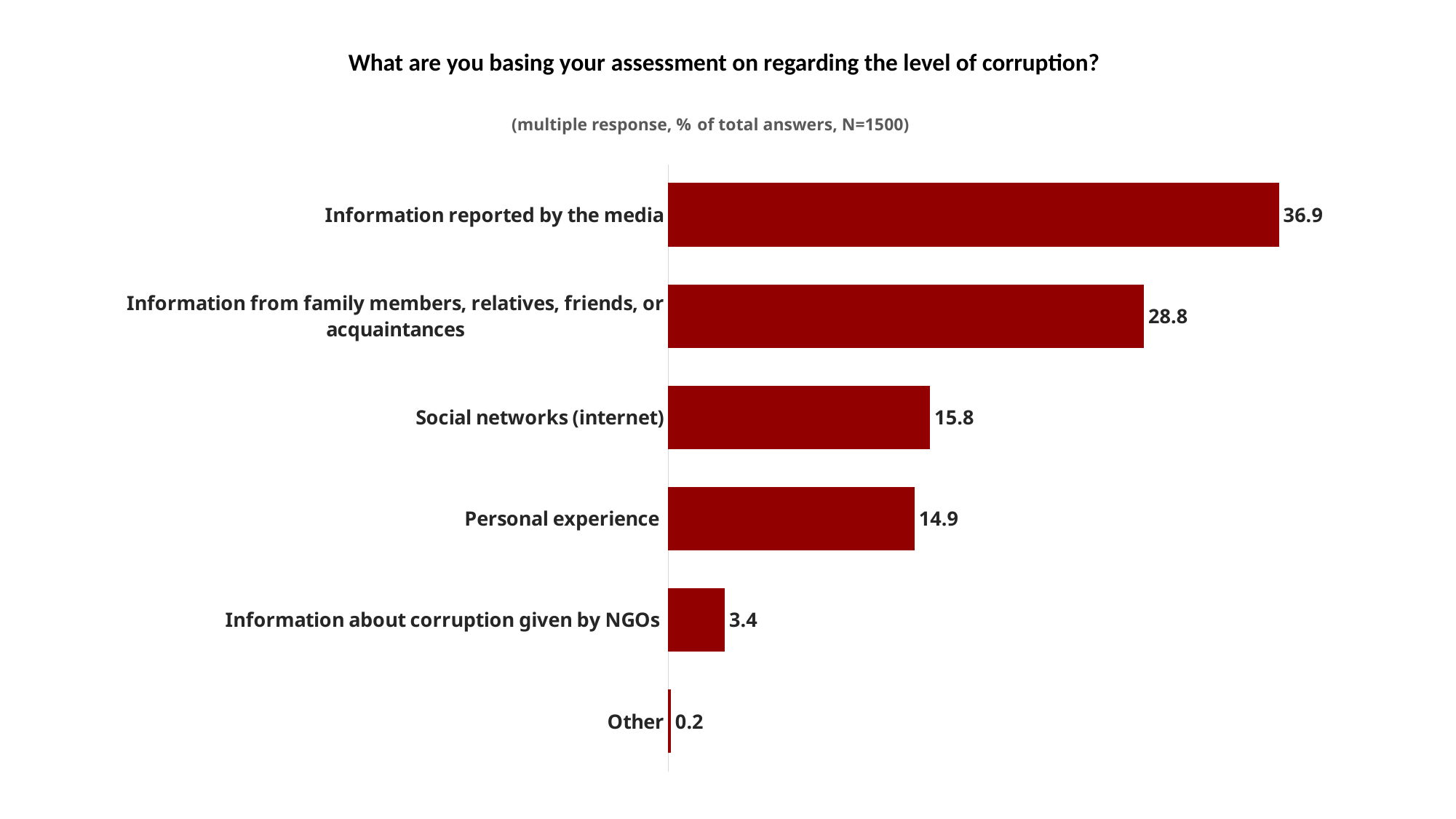
What is the sample size (N) stated in the chart subtitle? N=1500 What kind of chart is shown on the slide? Bar chart Which is larger, the value for "Personal experience" or the value for "Information about corruption given by NGOs"? Personal experience What is the value for "Information reported by the media"? 36.9 What is the value for "Social networks (internet)"? 15.8 What is the difference between the values for "Social networks (internet)" and "Personal experience"? 0.9 Which category has the lowest value? Other How many categories are shown in the chart? 6 What is the value for "Information about corruption given by NGOs"? 3.4 What is the value for "Other"? 0.2 Which category has the highest value? Information reported by the media What is the difference between the values for "Information reported by the media" and "Information from family members, relatives, friends, or acquaintances"? 8.1